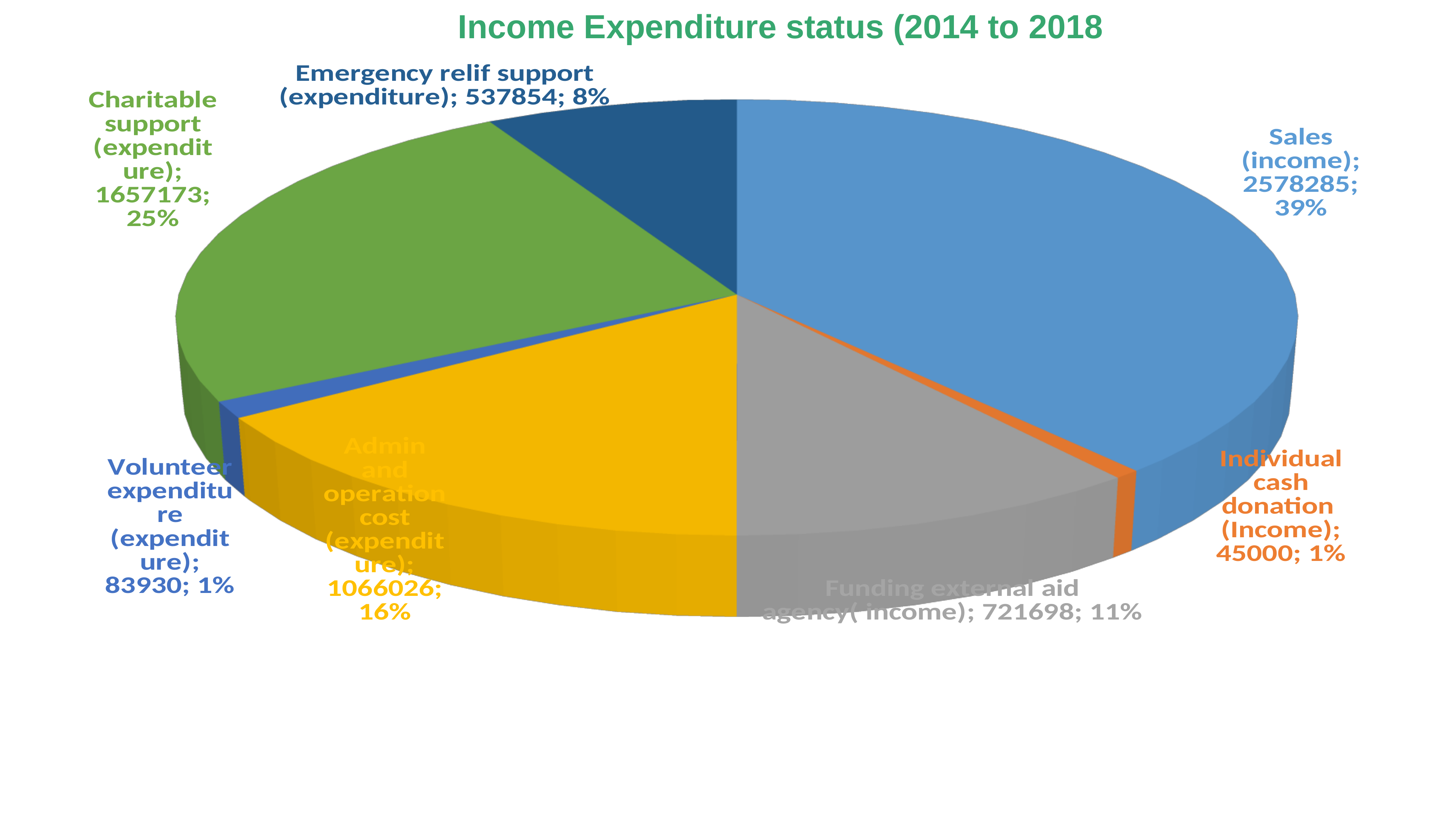
What is the difference between the values for Sales (income) and Charitable support (expenditure)? 921112 How many slices does the pie chart have? 7 Which category has the largest slice of the pie? Sales (income) What share of the pie does Individual cash donation (Income) represent? 1% What is the value for Sales (income)? 2578285 What share of the pie does Emergency relif support (expenditure) represent? 8% Which is larger, the value for Admin and operation cost (expenditure) or the value for Funding external aid agency( income)? Admin and operation cost (expenditure) What is the title of the chart? Income Expenditure status (2014 to 2018 What is the value for Charitable support (expenditure)? 1657173 What kind of chart is shown on the slide? Pie chart What is the value for Funding external aid agency( income)? 721698 What is the value for Admin and operation cost (expenditure)? 1066026